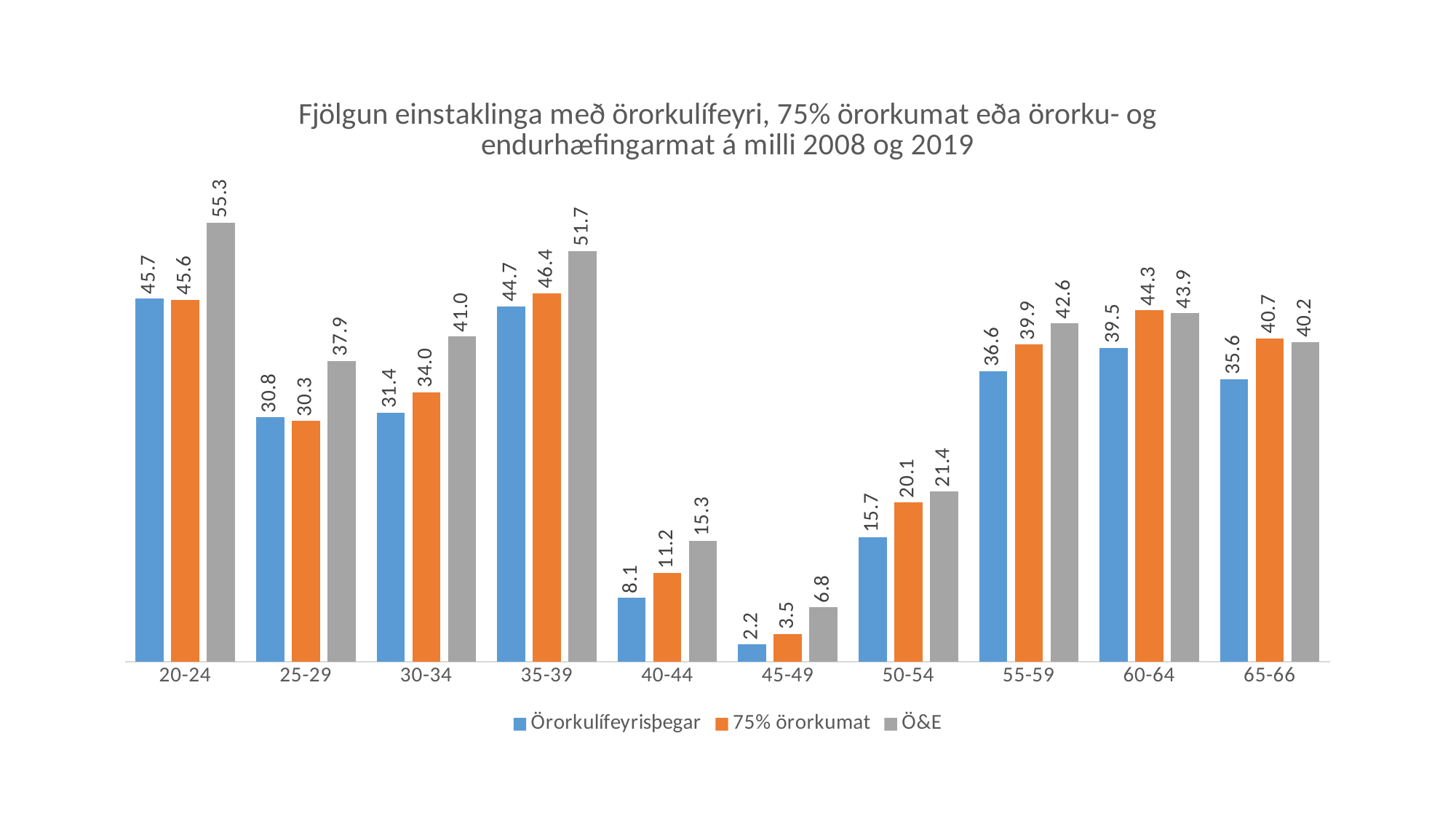
How many series does the legend list? 3 Which age group has the highest value for Ö&E? 20-24 What is the value for Örorkulífeyrisþegar in the 45-49 age group? 2.2 How many age groups are shown on the x axis? 10 Which colour represents the Ö&E series in the legend? Grey What is the value for Ö&E in the 20-24 age group? 55.3 What is the difference between the Ö&E value and the Örorkulífeyrisþegar value in the 25-29 age group? 7.1 What is the value for 75% örorkumat in the 50-54 age group? 20.1 Do the Örorkulífeyrisþegar values rise or fall from the 35-39 age group to the 45-49 age group? Fall Which is larger in the 60-64 age group: 75% örorkumat or Ö&E? 75% örorkumat Which age group has the lowest value for 75% örorkumat? 45-49 What kind of chart is shown on the slide? Bar chart